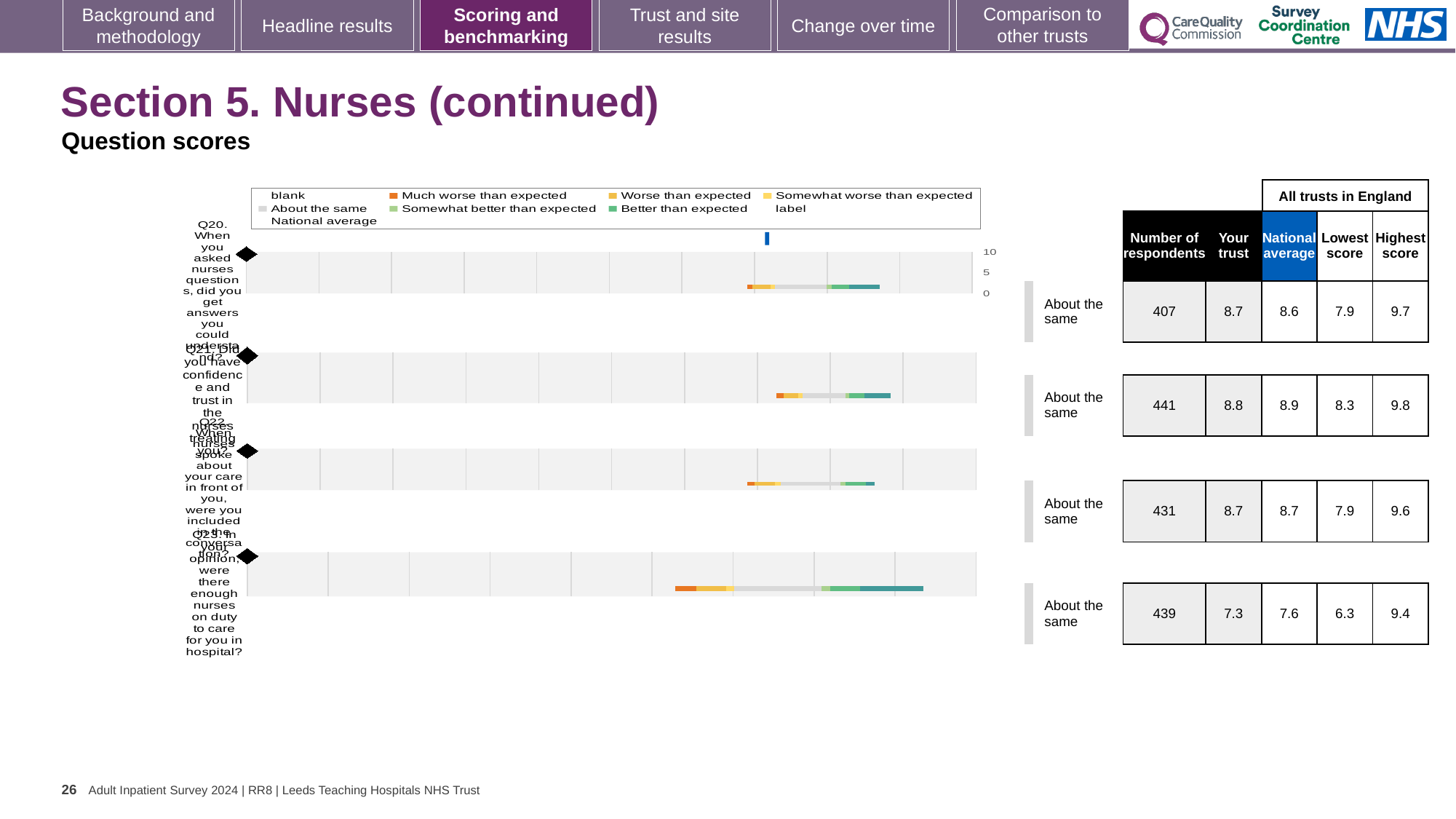
In the table beside the chart, which question has the lowest 'Your trust' score? Q23 In the table beside the chart, what is the difference between the highest score and lowest score for Q23? 3.1 Which question is plotted at the top of the chart? Q20 In the table beside the chart, is the 'Your trust' score for Q21 larger or smaller than the national average for Q21? smaller How many questions (categories) are plotted in the chart? 4 How many entries does the chart legend list? 9 What colour does the legend use for 'Much worse than expected'? orange What kind of chart is shown on the slide? bar chart In the table beside the chart, what is the national average for Q23? 7.6 What is the highest tick value shown on the chart's axis? 10 In the table beside the chart, which question has the highest 'Your trust' score? Q21 In the table beside the chart, what is the 'Your trust' score for Q20? 8.7